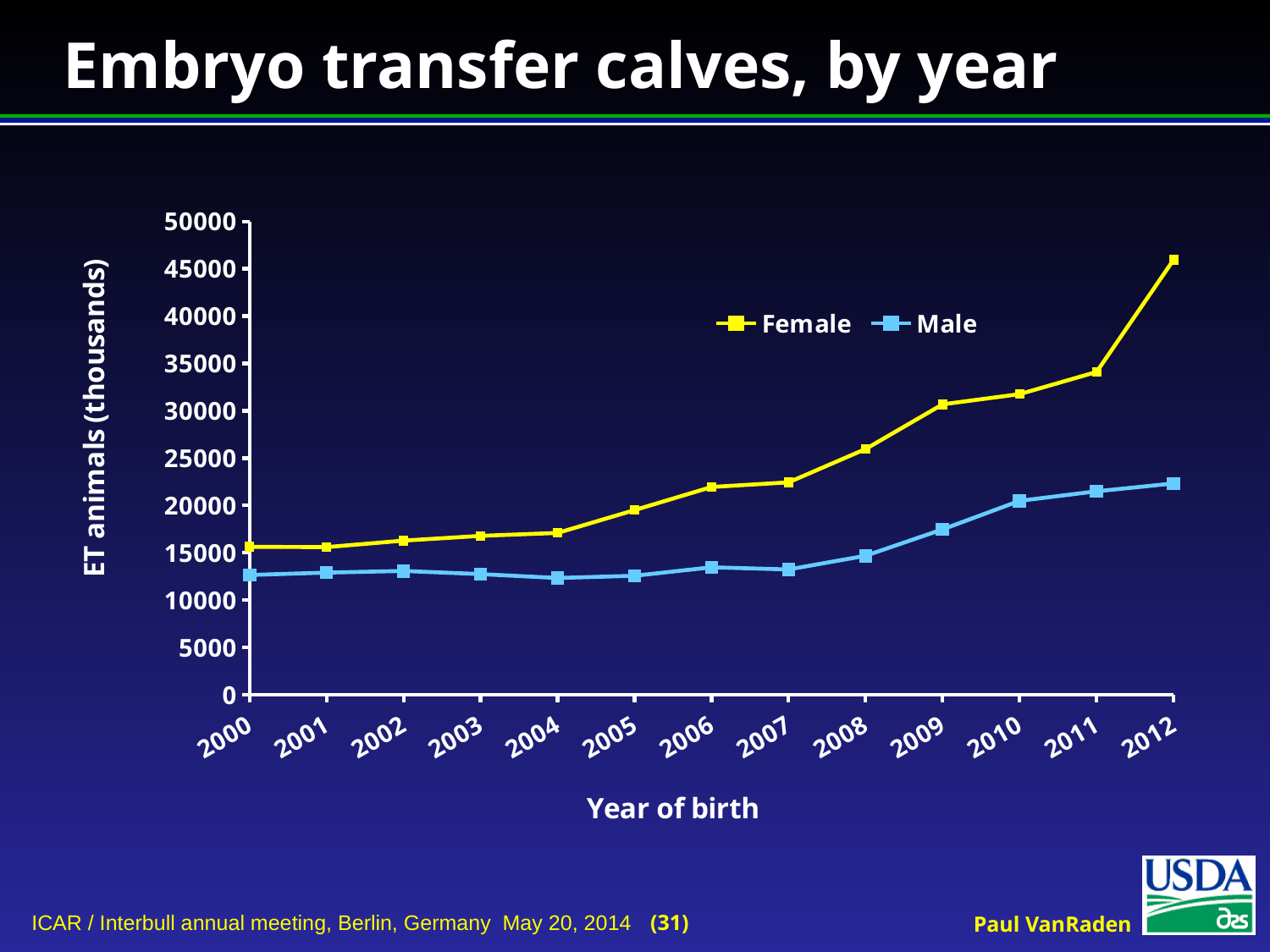
In which year is the Female series at its highest? 2012 In 2008, which series has the larger value, Female or Male? Female In which year is the Male series at its highest? 2012 How many series does the legend list? 2 What is the title of the x axis? Year of birth Is the Female value for 2009 greater or less than 25000? greater Is the Male value for 2000 greater or less than 15000? less Is the Female value for 2012 greater or less than 40000? greater What kind of chart is shown on the slide? line chart Does the Female series generally rise or fall from 2000 to 2012? rise How many years are plotted along the x axis? 13